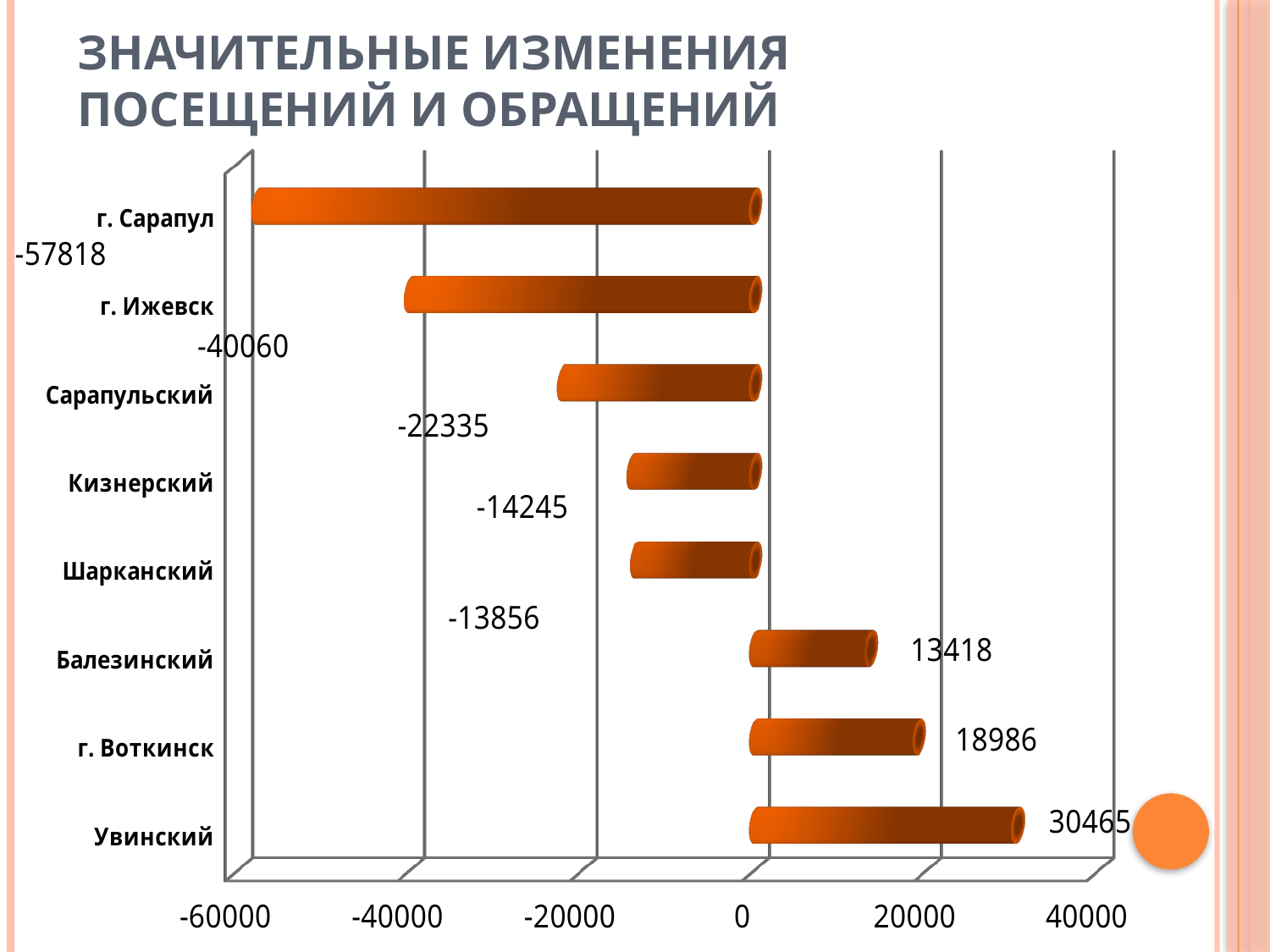
What is the difference between the values for Увинский and г. Воткинск? 11479 What kind of chart is shown on the slide? bar chart What is the value for г. Сарапул? -57818 Which category has the lowest value? г. Сарапул Is the value for г. Ижевск greater or less than -20000? less What is the value for Кизнерский? -14245 How many categories are shown in the chart? 8 Which category has the highest value? Увинский Which is larger, the value for Балезинский or the value for г. Воткинск? г. Воткинск What is the value for Увинский? 30465 How many categories have negative values? 5 What is the value for г. Воткинск? 18986